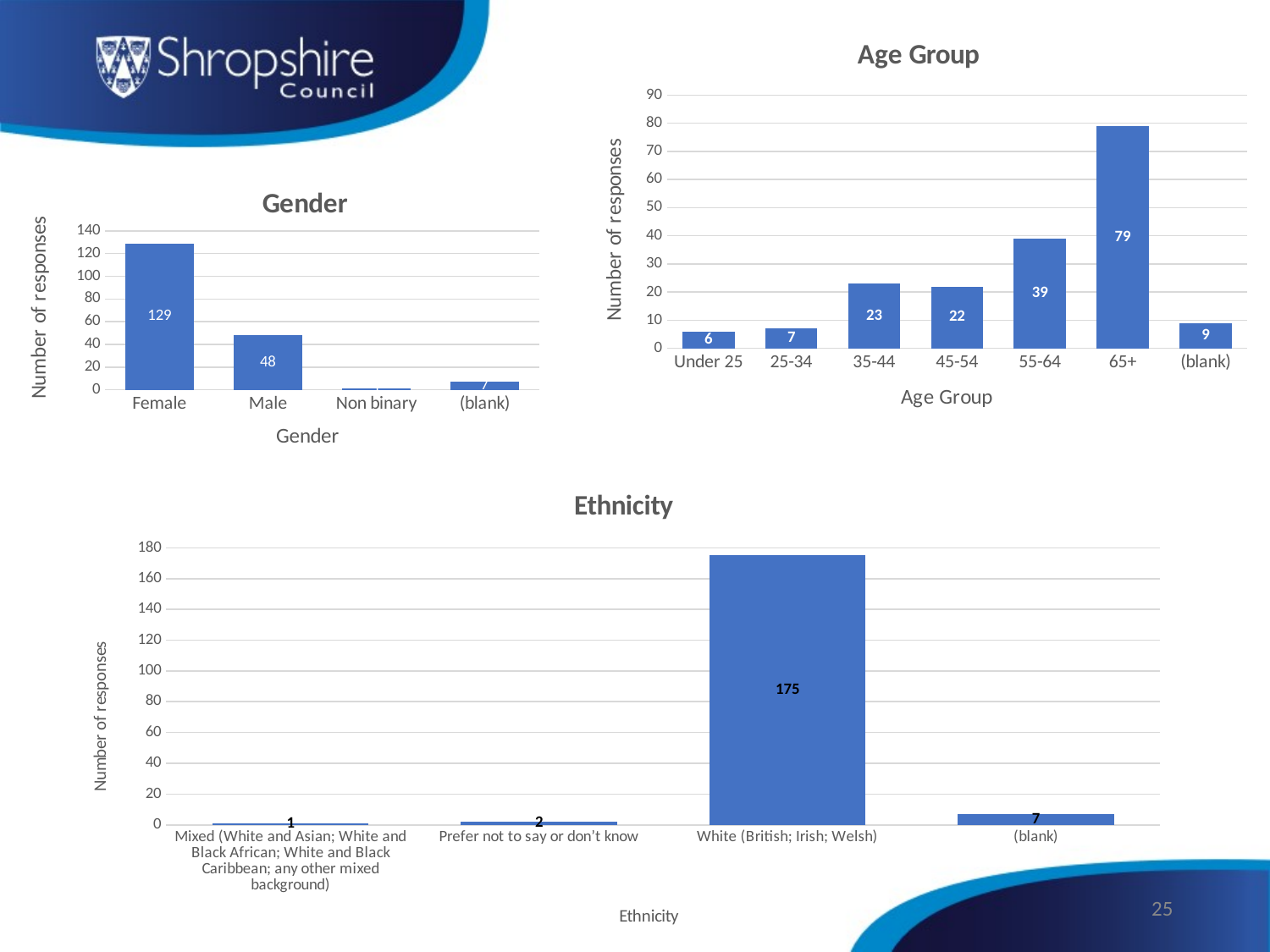
In the Age Group chart, what is the difference between the 65+ and 55-64 response counts? 40 What type of chart is the Ethnicity chart? Bar chart In the Age Group chart, which has more responses, 35-44 or 45-54? 35-44 In the Ethnicity chart, how many responses were from White (British; Irish; Welsh) respondents? 175 In the Gender chart, what is the difference between the Female and Male response counts? 81 In the Gender chart, how many responses were from Male respondents? 48 In the Age Group chart, which age group has the lowest number of responses? Under 25 In the Age Group chart, how many responses were from the 65+ age group? 79 In the Gender chart, how many responses were from Female respondents? 129 In the Gender chart, how many categories are shown on the x axis? 4 In the Age Group chart, how many responses were from the 55-64 age group? 39 In the Ethnicity chart, how many responses were in the (blank) category? 7